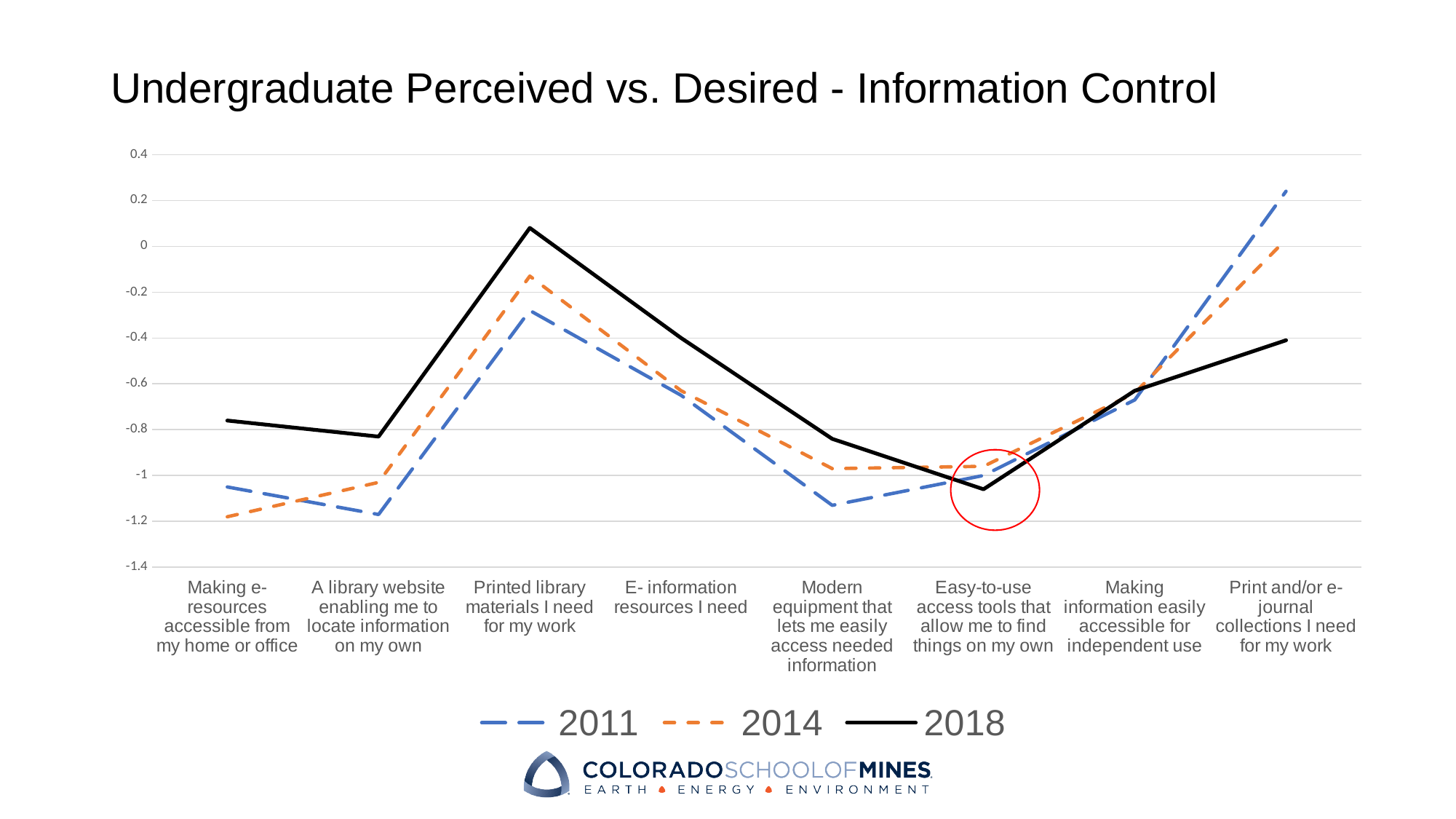
For 'Print and/or e-journal collections I need for my work', which series has the larger value, 2011 or 2018? 2011 For the 2018 series, which category has the lowest value? Easy-to-use access tools that allow me to find things on my own How many categories are shown along the x axis? 8 What is the title of the chart? Undergraduate Perceived vs. Desired - Information Control What kind of chart is shown on the slide? line chart For the 2011 series, which category has the highest value? Print and/or e-journal collections I need for my work For the 2018 series, which category has the highest value? Printed library materials I need for my work Is the 2011 value for 'Modern equipment that lets me easily access needed information' greater or less than -1? less Is the 2018 value for 'Printed library materials I need for my work' greater or less than 0? greater For 'Making e-resources accessible from my home or office', which series has the larger value, 2011 or 2018? 2018 Which category is highlighted with a red circle on the chart? Easy-to-use access tools that allow me to find things on my own How many series does the legend list? 3